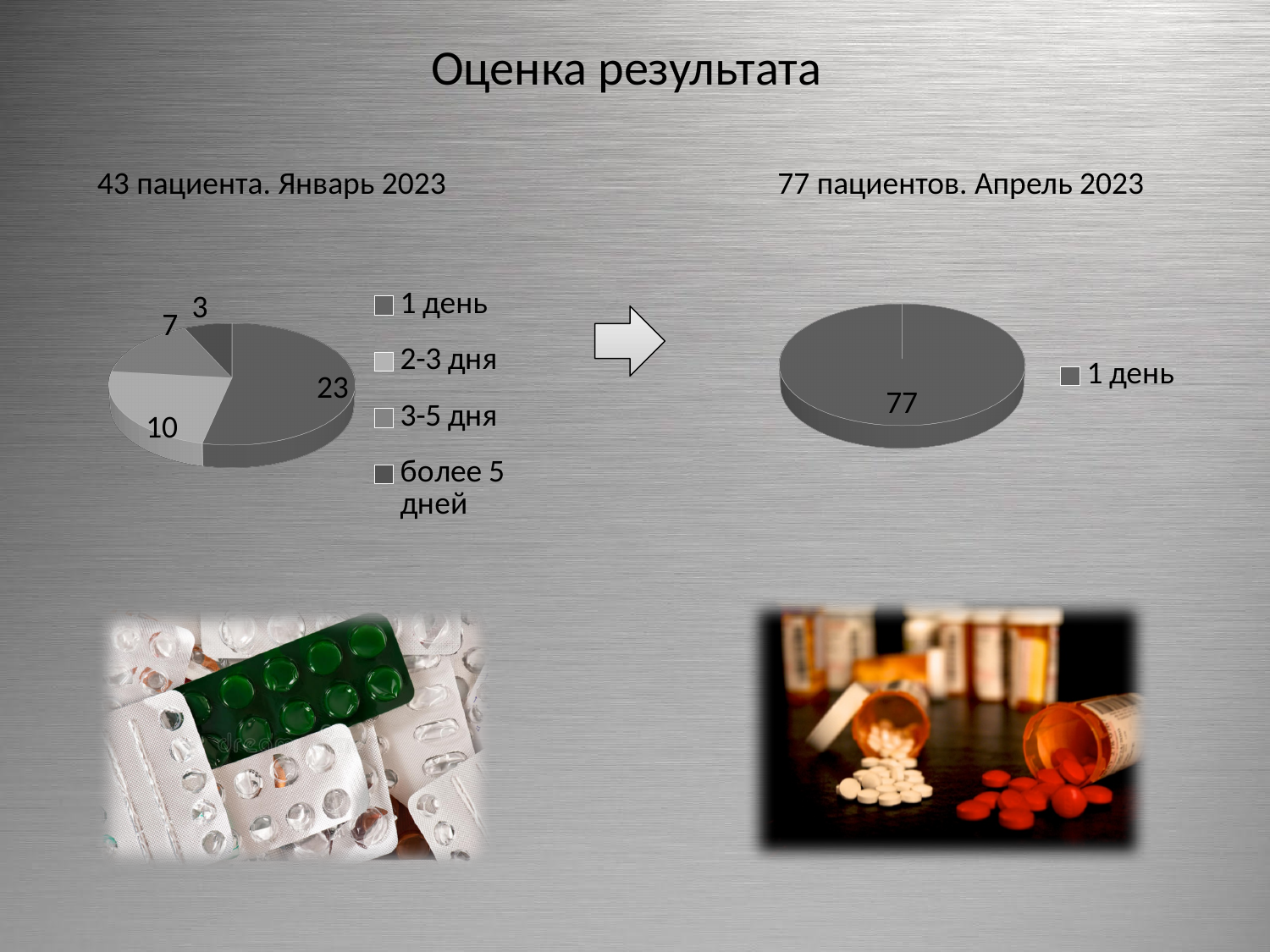
On the right chart (77 пациентов. Апрель 2023), what value is shown for 1 день? 77 On the left chart (43 пациента. Январь 2023), what value is shown for the slice labelled 3-5 дня? 7 On the left chart (43 пациента. Январь 2023), which category has the largest slice? 1 день On the left chart (43 пациента. Январь 2023), what value is shown for the slice labelled 2-3 дня? 10 How many entries does the legend of the right chart (77 пациентов. Апрель 2023) list? 1 On the left chart (43 пациента. Январь 2023), what is the difference between the values for 1 день and 2-3 дня? 13 What type of chart is used on the left side of the slide (43 пациента. Январь 2023)? Pie chart On the left chart (43 пациента. Январь 2023), what value is shown for the slice labelled более 5 дней? 3 On the left chart (43 пациента. Январь 2023), what value is shown for the slice labelled 1 день? 23 On the left chart (43 пациента. Январь 2023), which category has the smallest slice? более 5 дней On the left chart (43 пациента. Январь 2023), how many slices does the pie have? 4 On the right chart (77 пациентов. Апрель 2023), what share of the pie does the 1 день slice take? 100%